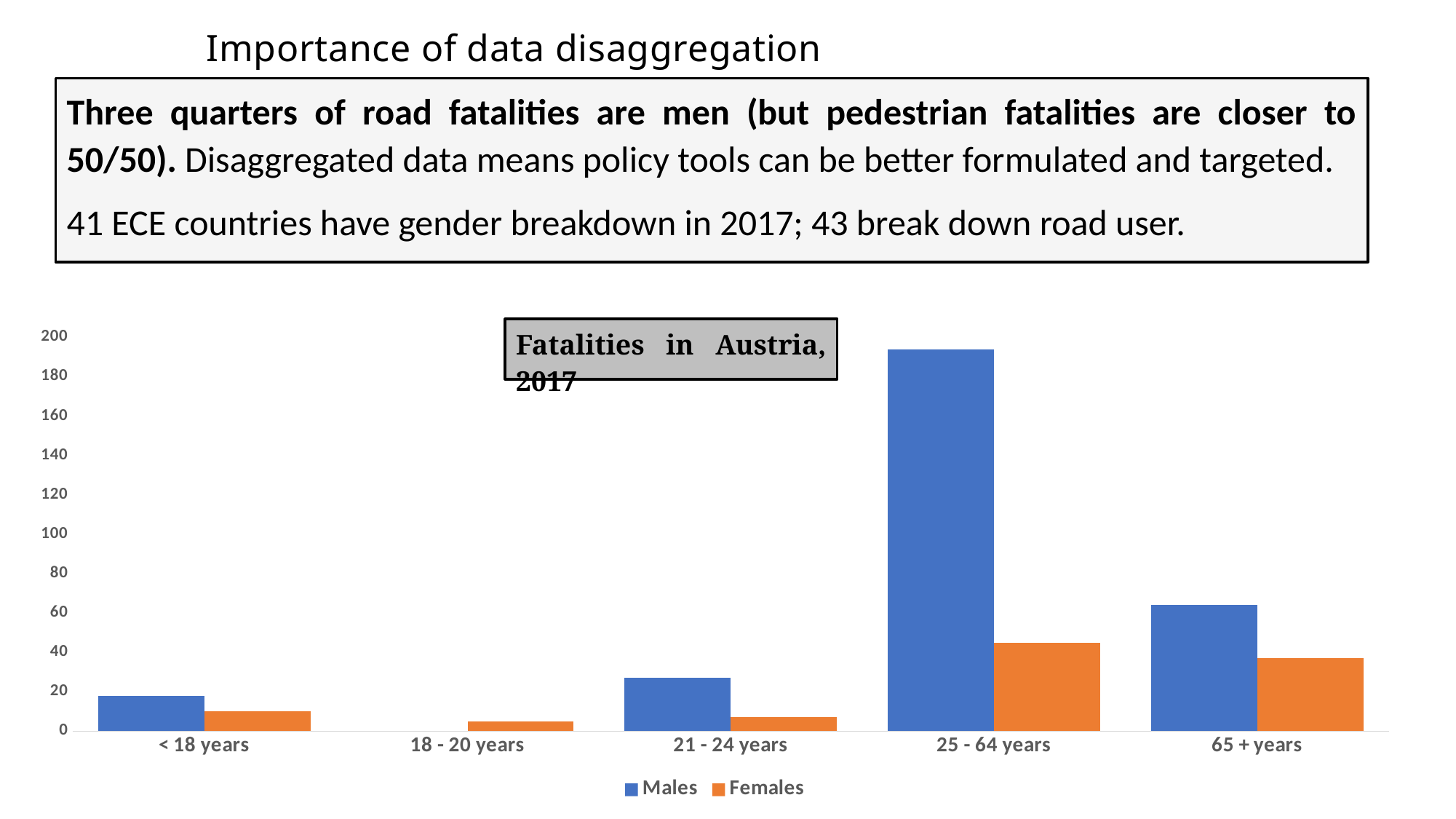
How many series does the legend of the chart list? 2 What kind of chart is shown on the slide? bar chart Which age category has the highest value for Males? 25 - 64 years Which age category has the highest value for Females? 25 - 64 years In the 18 - 20 years category, which series has the larger value, Males or Females? Females Is the value for Males in the 65 + years category greater or less than 80? less Is the value for Females in the 25 - 64 years category greater or less than 60? less How many age categories are shown on the x axis of the chart? 5 In the 65 + years category, which series has the larger value, Males or Females? Males Which age category has the lowest value for Males? 18 - 20 years Is the value for Males in the 25 - 64 years category greater or less than 180? greater What is the title of the chart? Fatalities in Austria, 2017